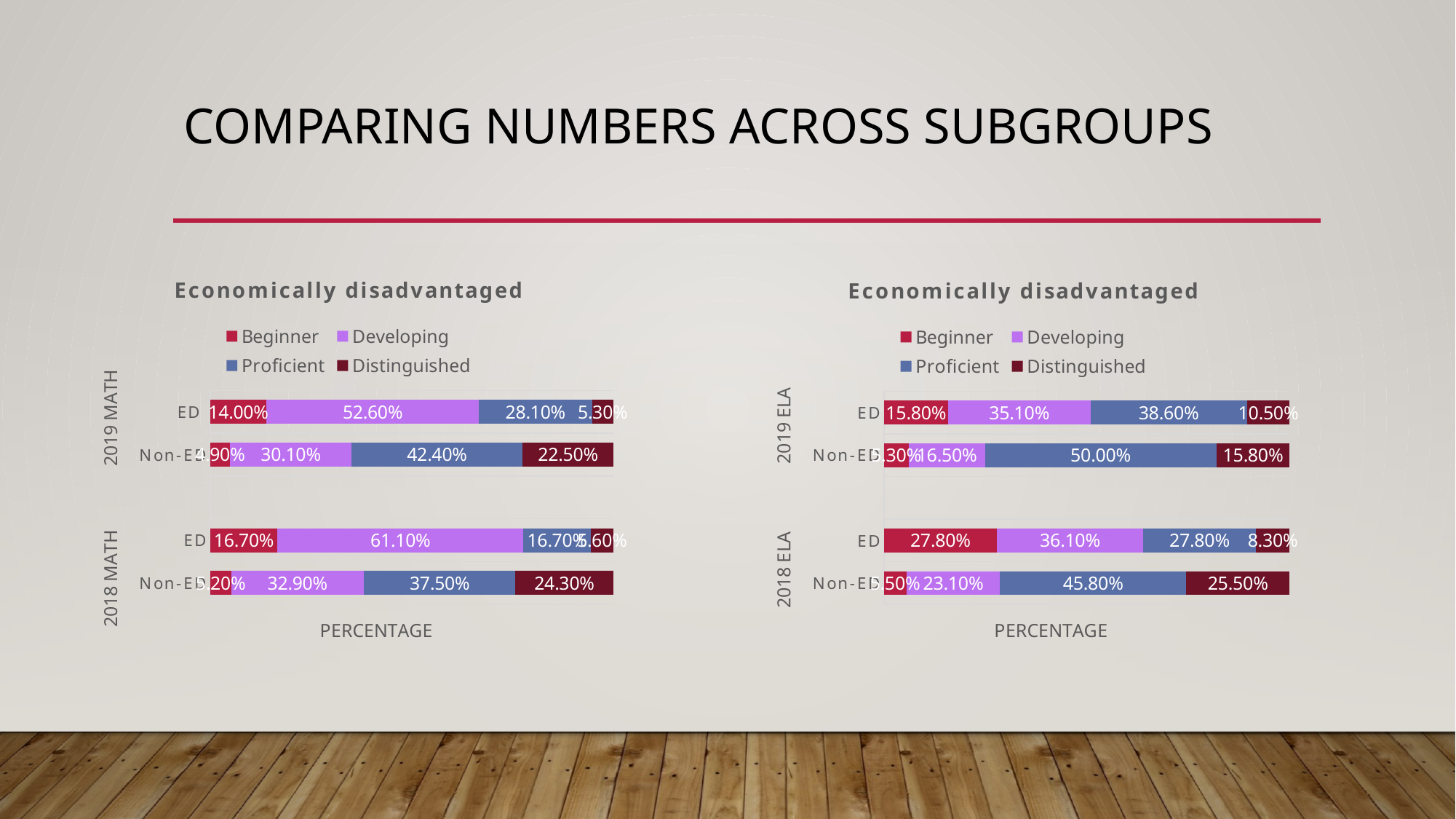
On the right chart (ELA), what percentage of 2018 Non-ED students were Distinguished? 25.50% On the right chart (ELA), which is larger: the Distinguished share for 2019 ED or for 2019 Non-ED? 2019 Non-ED On the left chart (Math), what percentage of 2019 Non-ED students were Distinguished? 22.50% On the left chart (Math), what percentage of 2019 ED students were Developing? 52.60% What kind of chart is the right chart? Stacked bar chart On the right chart (ELA), which proficiency level has the largest share for 2019 Non-ED students? Proficient On the right chart (ELA), what percentage of 2018 ED students were Beginner? 27.80% On the left chart (Math), what is the difference between the Proficient share for 2019 Non-ED (42.40%) and 2019 ED (28.10%)? 14.30% On the left chart (Math), what percentage of 2018 ED students were Developing? 61.10% How many series does the legend of the left chart list? 4 On the left chart (Math), which proficiency level has the largest share for 2019 ED students? Developing On the right chart (ELA), what percentage of 2019 Non-ED students were Proficient? 50.00%